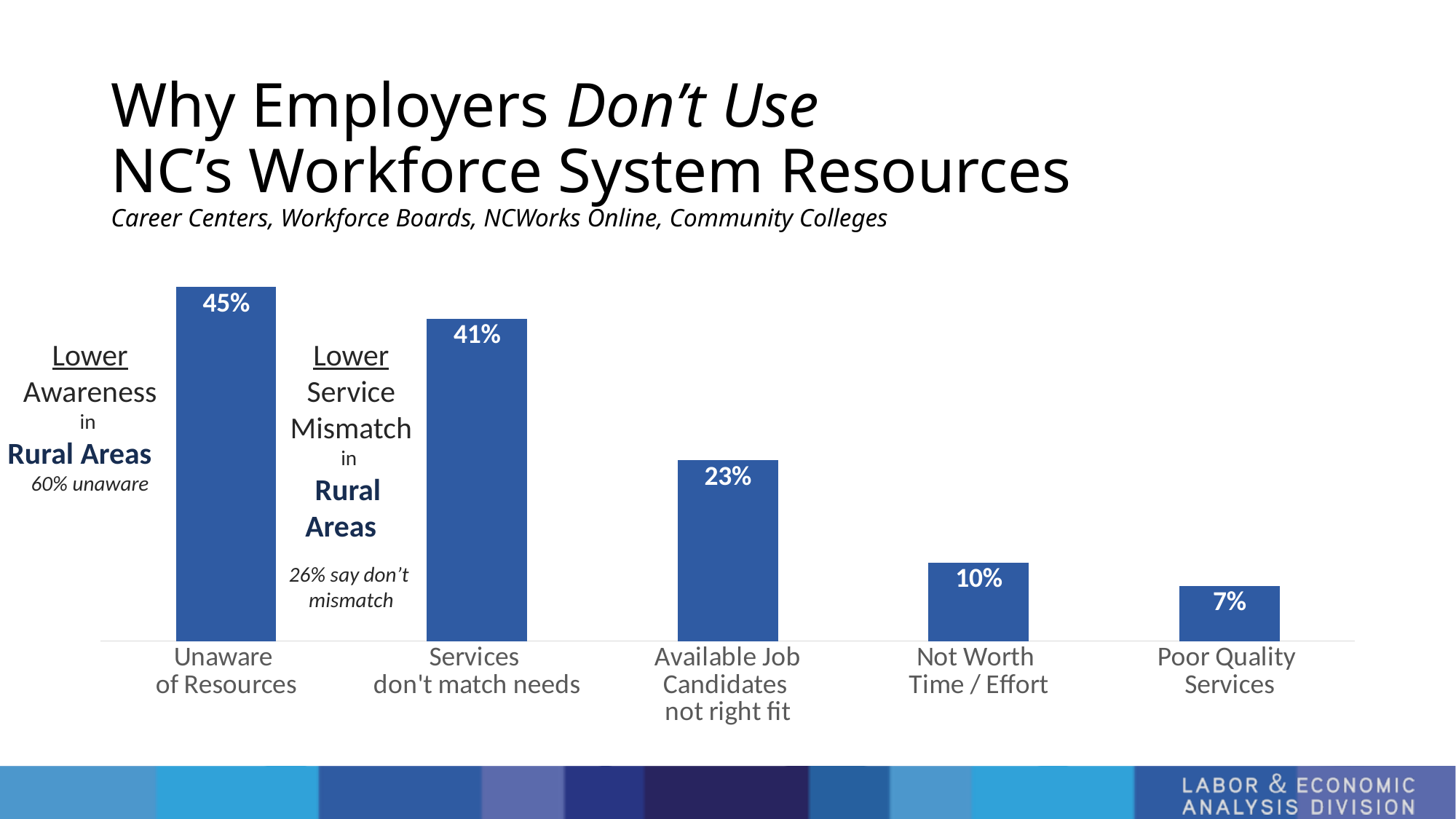
What kind of chart is shown on the slide? Bar chart How many reasons (categories) are shown in the chart? 5 Which is larger: 'Available Job Candidates not right fit' or 'Not Worth Time / Effort'? Available Job Candidates not right fit What is the value for 'Poor Quality Services'? 7% Do the values rise or fall from left to right across the categories? Fall What is the value for 'Services don't match needs'? 41% What percentage of employers cite being unaware of resources as a reason for not using NC's workforce system resources? 45% What is the difference between 'Unaware of Resources' and 'Services don't match needs'? 4 percentage points Which reason has the lowest percentage? Poor Quality Services What is the difference between 'Not Worth Time / Effort' and 'Poor Quality Services'? 3 percentage points Which reason has the highest percentage? Unaware of Resources What percentage is shown for 'Available Job Candidates not right fit'? 23%